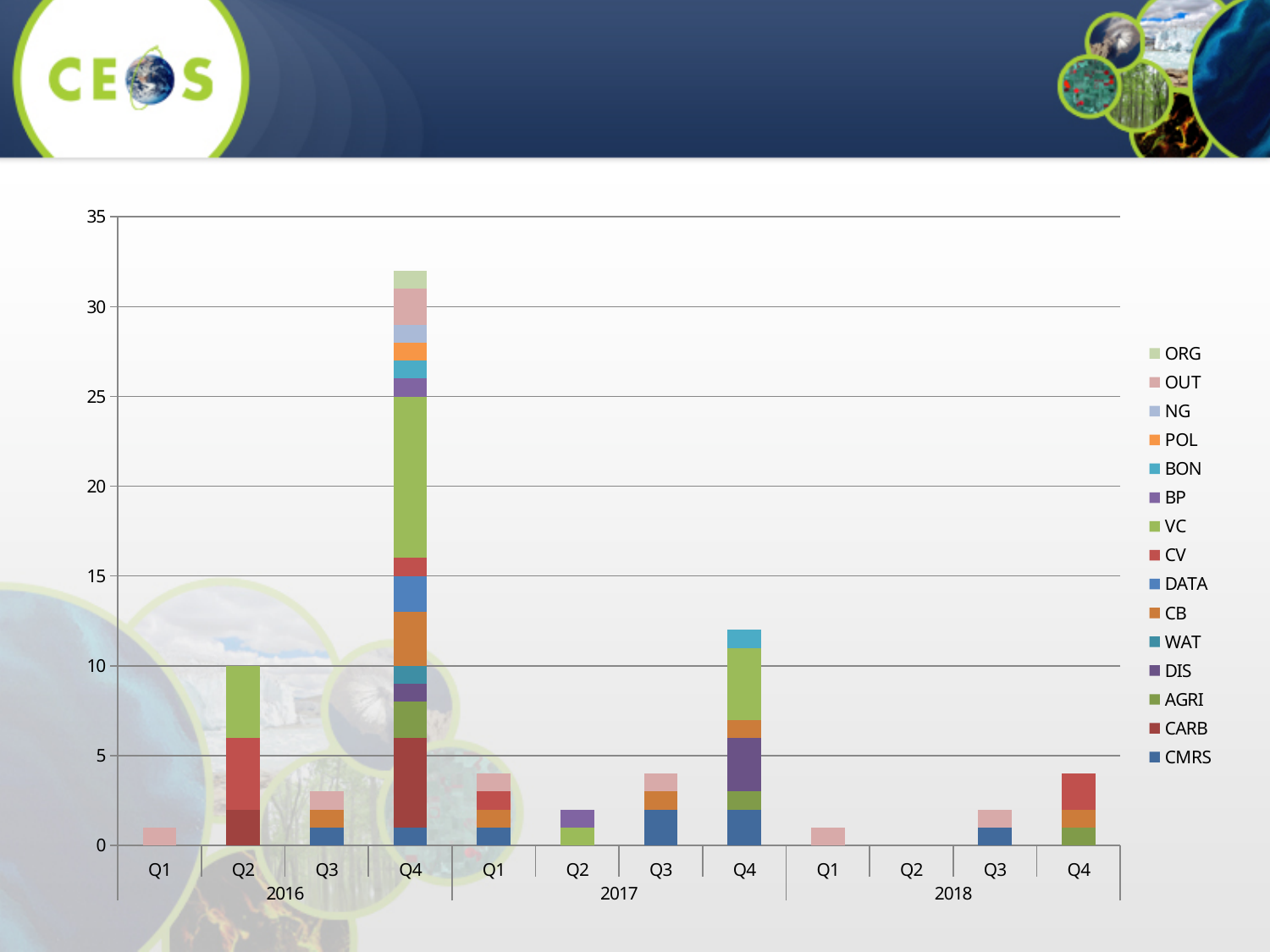
Is the total for Q4 2017 greater or less than 10? greater Which quarter in 2018 has no bar at all? Q2 Which series is listed last (at the bottom) in the legend? CMRS Which has the larger total, Q4 2016 or Q4 2017? Q4 2016 How many quarter categories are shown along the x axis? 12 Which series is listed first (at the top) in the legend? ORG What is the total height of the stacked bar for Q2 2016? 10 How many series does the legend list? 15 What kind of chart is shown on the slide? stacked bar chart Is the total for Q4 2016 greater or less than 30? greater Is the total for Q3 2016 greater or less than 5? less Which quarter has the tallest stacked bar? Q4 2016